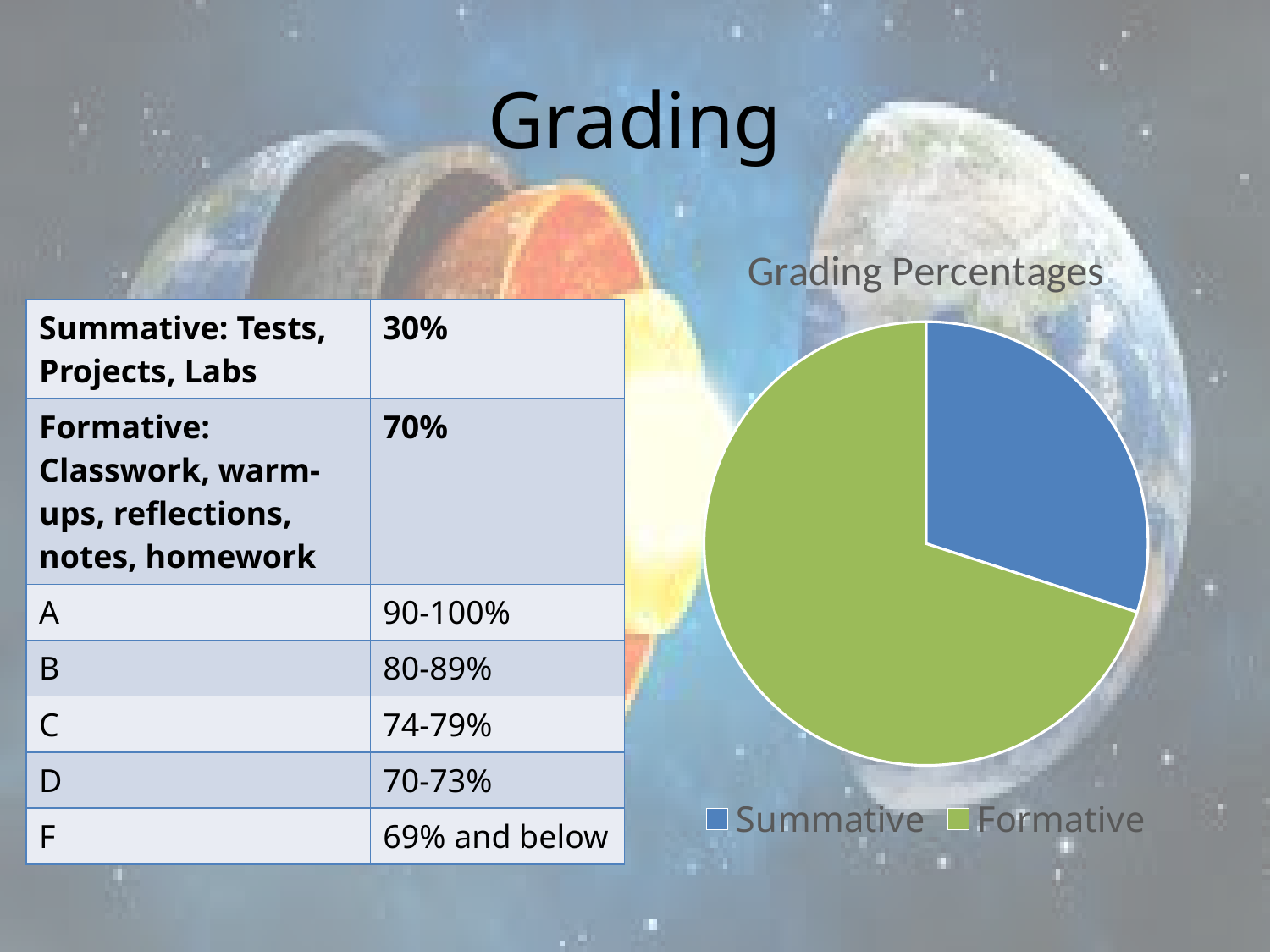
What is the title of the pie chart on the slide? Grading Percentages What kind of chart is shown under the title "Grading Percentages"? pie chart Which category takes the smallest slice of the "Grading Percentages" pie chart? Summative In the "Grading Percentages" pie chart, which slice is larger, Summative or Formative? Formative By how many percentage points does the Formative share exceed the Summative share in the "Grading Percentages" chart? 40 What share of the "Grading Percentages" pie does the Formative slice represent, according to the slide? 70% What share of the "Grading Percentages" pie does the Summative slice represent, according to the slide? 30% What colour is the Formative slice in the "Grading Percentages" pie chart? green How many slices does the "Grading Percentages" pie chart have? 2 How many entries does the legend of the "Grading Percentages" chart list? 2 Which category takes the largest slice of the "Grading Percentages" pie chart? Formative